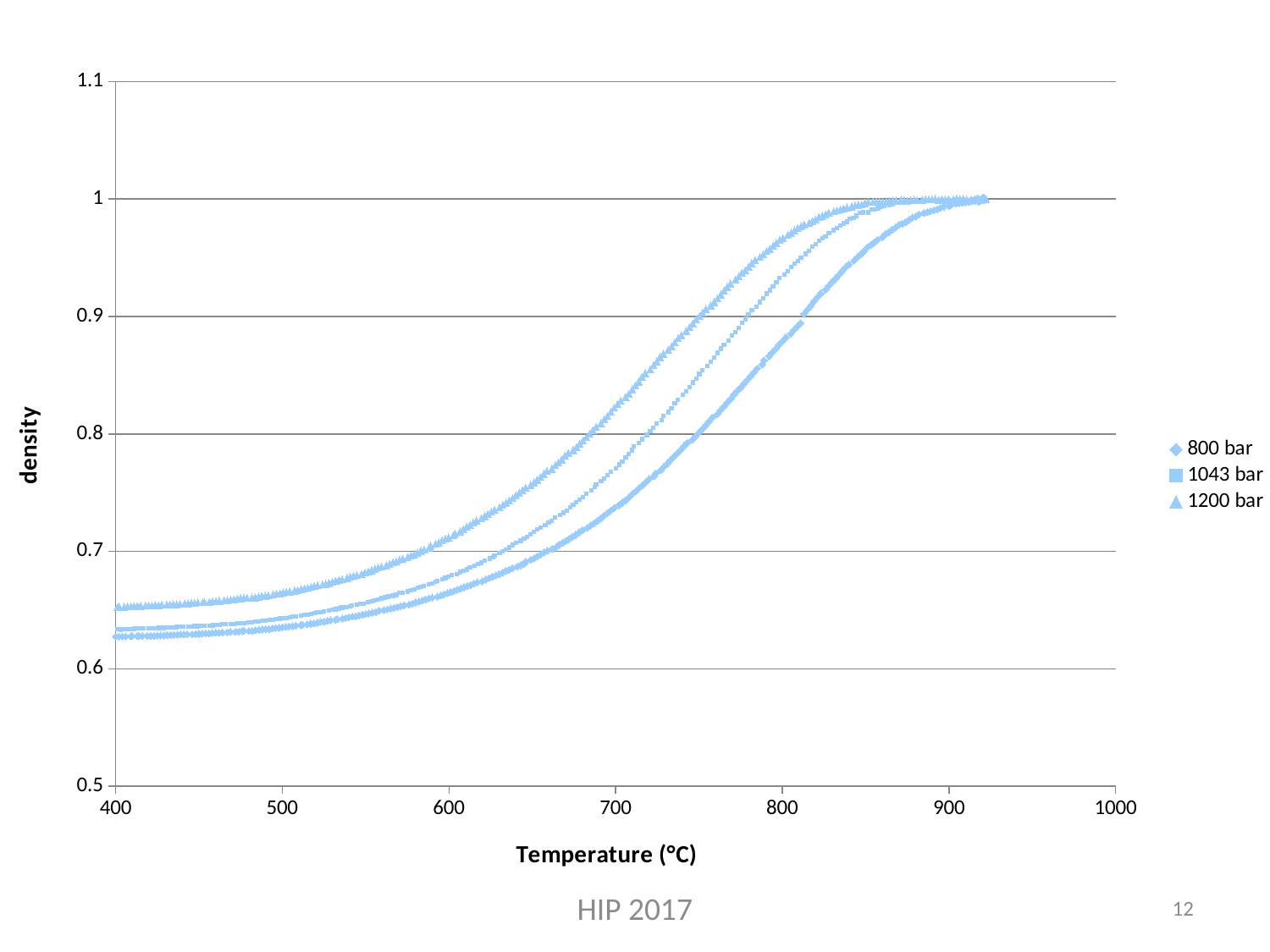
At 400°C, is the density for the 1200 bar series greater or less than 0.7? less At 700°C, is the density for the 800 bar series greater or less than 0.8? less At 800°C, is the density for the 1200 bar series greater or less than 0.9? greater What kind of chart is shown on the slide? scatter chart At 700°C, which series has the highest density? 1200 bar At 750°C, which series has the higher density, 800 bar or 1043 bar? 1043 bar At 700°C, which series has the lowest density? 800 bar How many series does the legend list? 3 Do the density values rise or fall as temperature increases along the x axis? rise What is the title of the x axis? Temperature (°C)